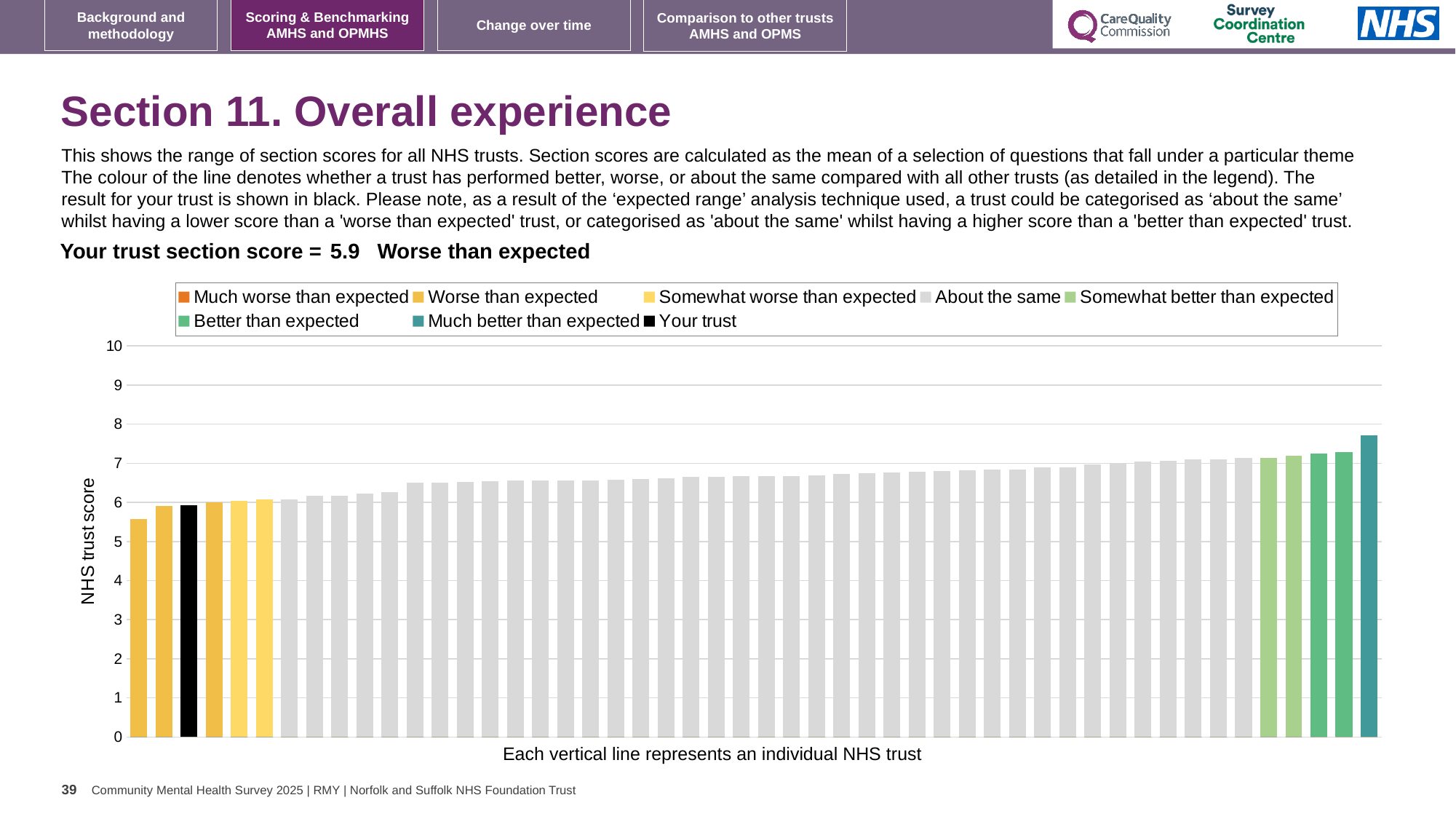
What is the label on the vertical axis of the chart? NHS trust score Which performance category is your trust placed in for this section? Worse than expected What kind of chart is shown on the slide? bar chart How many bars are coloured as 'Much better than expected'? 1 What is the section score for your trust shown on the slide? 5.9 Do the bar values rise or fall from left to right along the x axis? rise Is the value for the shortest bar in the chart greater or less than 5? greater Is the value for the tallest bar in the chart greater or less than 7? greater Which legend category does the highest bar in the chart belong to? Much better than expected How many entries does the chart legend list? 8 Is the value for the black 'Your trust' bar greater or less than 6? less Which is larger, the leftmost bar or the rightmost bar? the rightmost bar